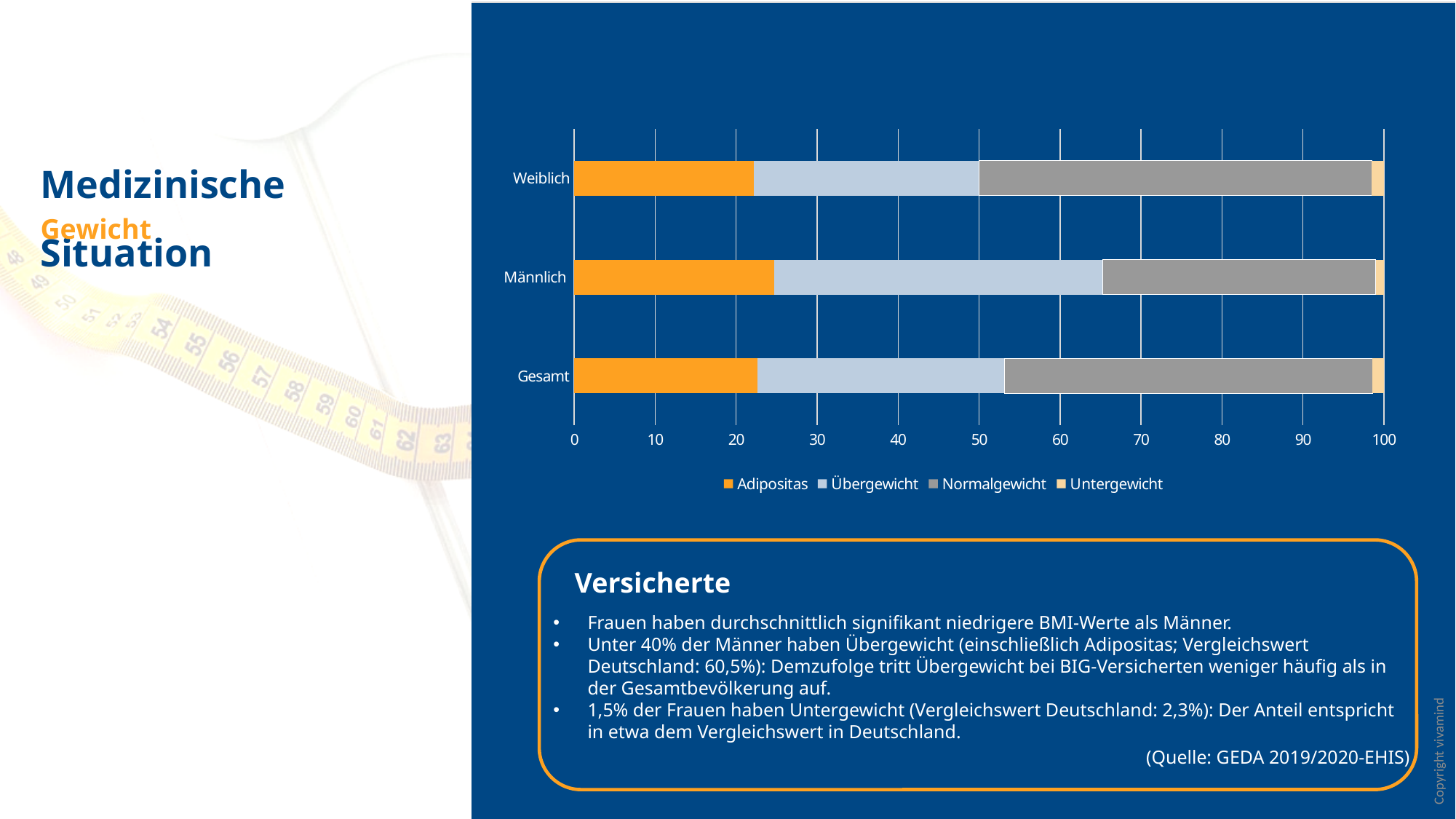
Is the Untergewicht segment larger for Weiblich or for Männlich? Weiblich Is the Normalgewicht value for Weiblich greater or less than 40? greater Is the Übergewicht segment larger for Männlich or for Weiblich? Männlich Is the Adipositas value for Männlich greater or less than 20? greater Which category has the largest Normalgewicht segment? Weiblich Which series is shown in orange in the chart? Adipositas Which series appears last in the chart legend? Untergewicht How many series does the chart legend list? 4 What kind of chart is shown on the slide? Stacked bar chart Is the Adipositas value for Weiblich greater or less than 30? less How many categories are shown on the vertical axis of the chart? 3 Which category has the largest Übergewicht segment? Männlich